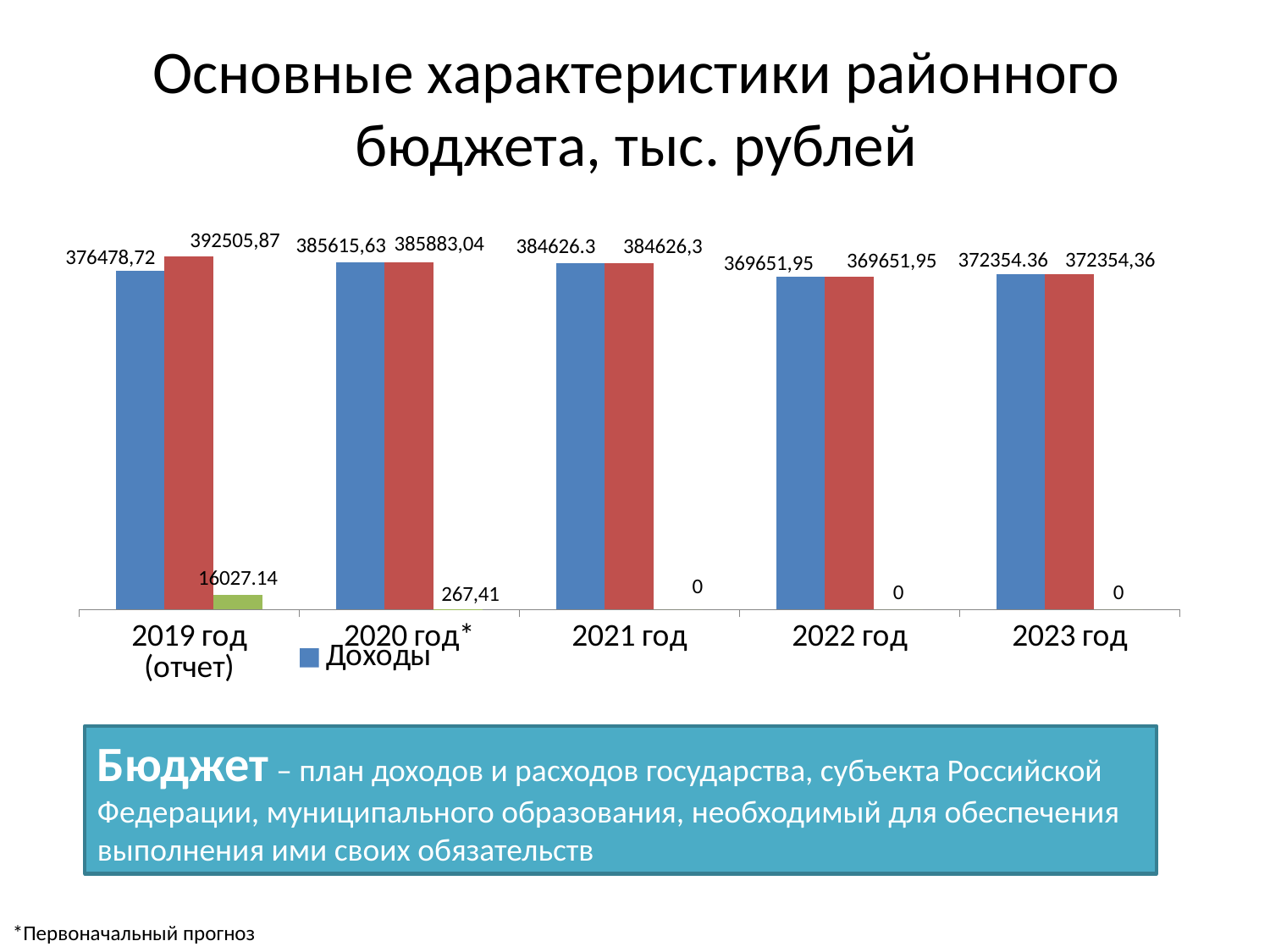
What type of chart is shown on the slide? bar chart How many year categories are shown on the x axis? 5 Which year has the lowest value of Доходы? 2022 год What is the value of the green series for 2019 год (отчет)? 16027.14 What is the value of Доходы for 2020 год*? 385615,63 What is the value of the red series for 2019 год (отчет)? 392505,87 What is the value of Доходы for 2022 год? 369651,95 Which year has the highest value of Доходы? 2020 год* What is the title of the chart on the slide? Основные характеристики районного бюджета, тыс. рублей What is the value of the green series for 2020 год*? 267,41 What is the value of Доходы for 2019 год (отчет)? 376478,72 What is the value of the green series for 2023 год? 0